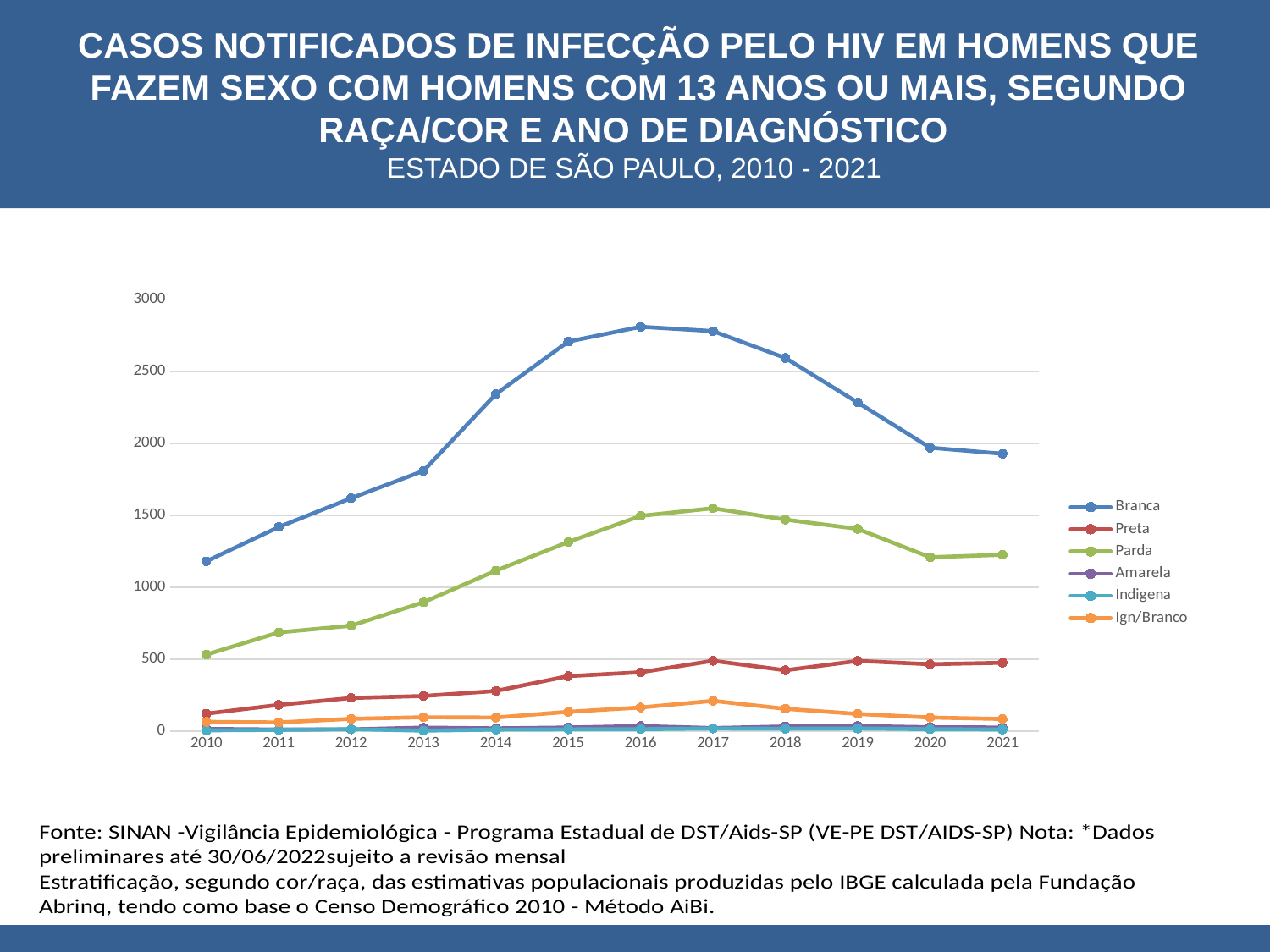
Is the value for Preta in 2010 greater or less than 500? less Does the Branca line rise or fall from 2017 to 2021? fall Which series has the highest values across the whole period? Branca What kind of chart is shown on the slide? line chart How many years are plotted along the x axis? 12 Is the value for Parda in 2010 greater or less than 1000? less How many series does the legend list? 6 Is the value for Branca in 2016 greater or less than 2500? greater Which is larger in 2015, the value for Parda or the value for Preta? Parda What colour is the Branca line? blue